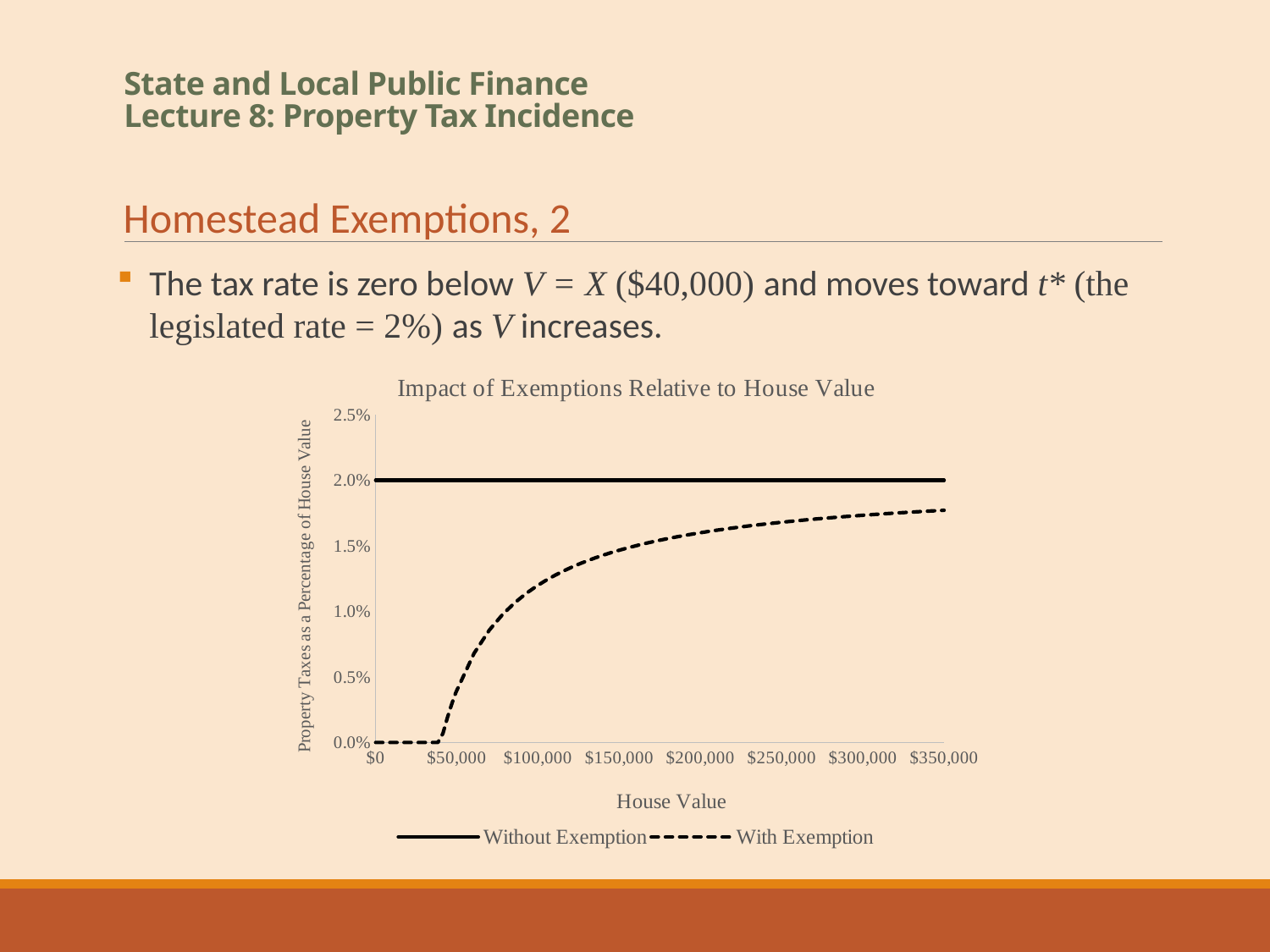
What is the label of the x axis? House Value What is the value of the With Exemption series at a house value of $0? 0.0% What is the value of the Without Exemption series across all house values? 2.0% Is the value of the With Exemption series at $100,000 greater or less than 1.5%? less Is the value of the With Exemption series at $350,000 greater or less than 1.5%? greater Which series is drawn with a dashed line? With Exemption How many series does the chart legend list? 2 Does the With Exemption series rise or fall as house value increases? rise What is the title of the chart? Impact of Exemptions Relative to House Value Is the value of the With Exemption series at $200,000 greater or less than 1.0%? greater Which series is higher at a house value of $100,000, Without Exemption or With Exemption? Without Exemption What kind of chart is shown on the slide? line chart